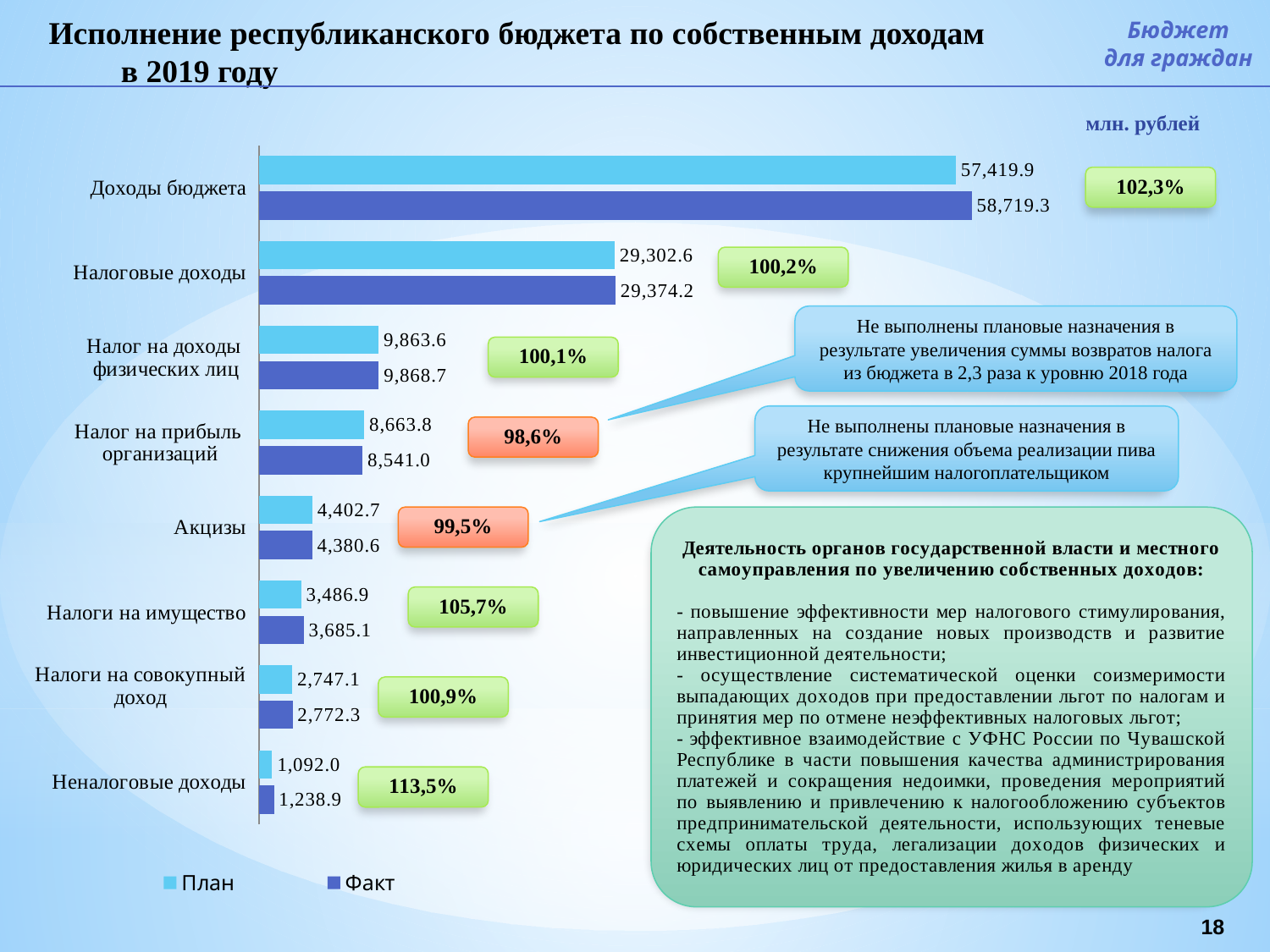
What is the План (plan) value for Доходы бюджета? 57,419.9 Which category has the lowest План value? Неналоговые доходы For Акцизы, which is larger: the План value or the Факт value? План What kind of chart is shown on the slide? Bar chart What is the Факт (actual) value for Налоговые доходы? 29,374.2 What is the difference between the Факт and План values for Налоги на имущество? 198.2 What is the План value for Неналоговые доходы? 1,092.0 What is the Факт value for Налог на прибыль организаций? 8,541.0 What is the difference between the Факт and План values for Доходы бюджета? 1,299.4 How many categories are shown on the chart? 8 Which category has the highest Факт value? Доходы бюджета How many series does the legend list? 2